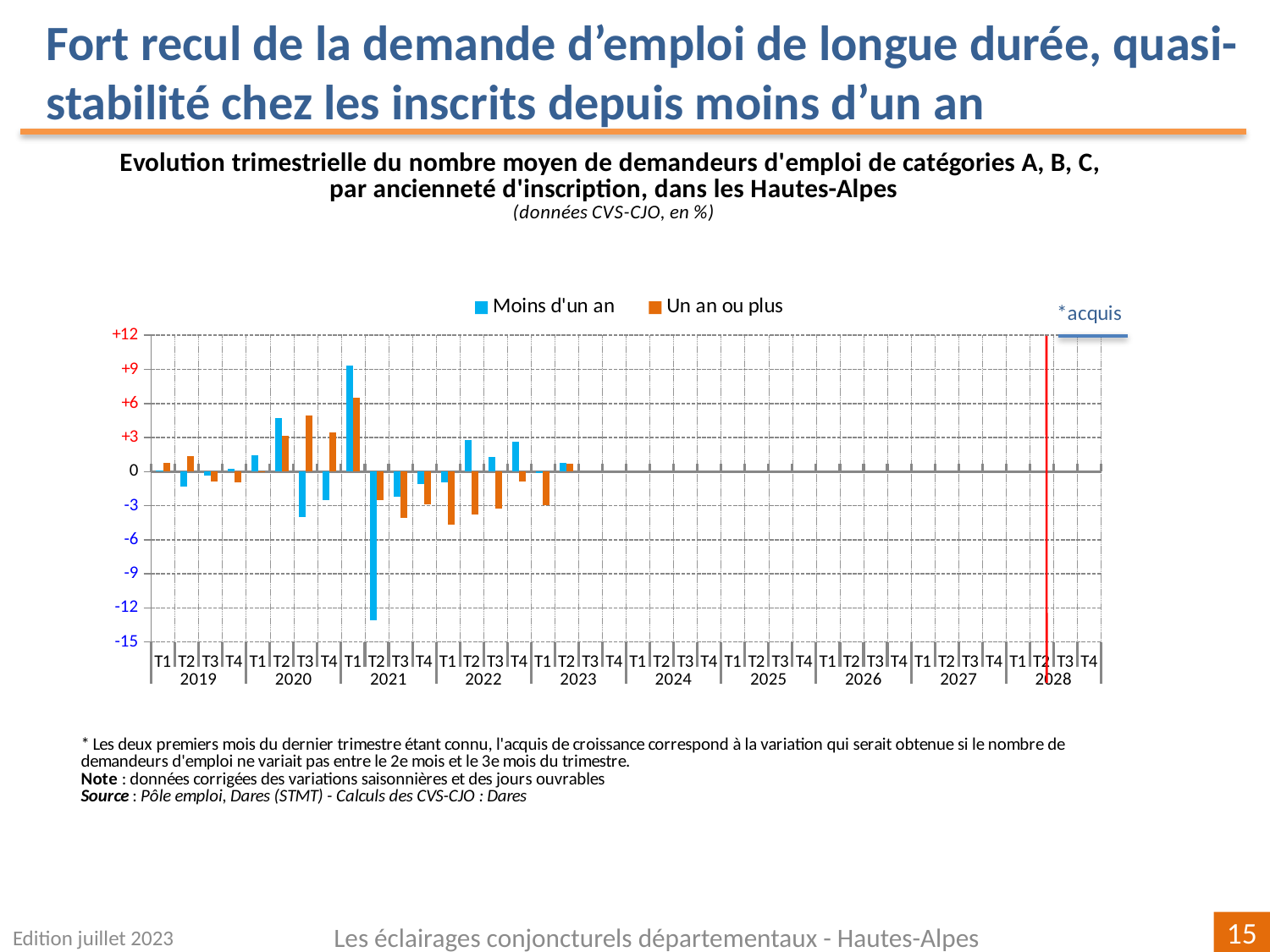
Is the value for 'Un an ou plus' in T1 2021 greater or less than +3? greater How many series does the chart legend list? 2 What are the two series named in the chart legend? Moins d'un an; Un an ou plus In which quarter does the 'Moins d'un an' series reach its lowest value? T2 2021 Is the value for 'Un an ou plus' in T1 2022 greater or less than -3? less In which quarter does the 'Un an ou plus' series reach its highest value? T1 2021 Is the value for 'Moins d'un an' in T1 2021 greater or less than +6? greater What kind of chart is shown on the slide? Bar chart In T3 2020, which series has the larger value, 'Moins d'un an' or 'Un an ou plus'? Un an ou plus In which quarter does the 'Moins d'un an' series reach its highest value? T1 2021 In T2 2020, which series has the larger value, 'Moins d'un an' or 'Un an ou plus'? Moins d'un an